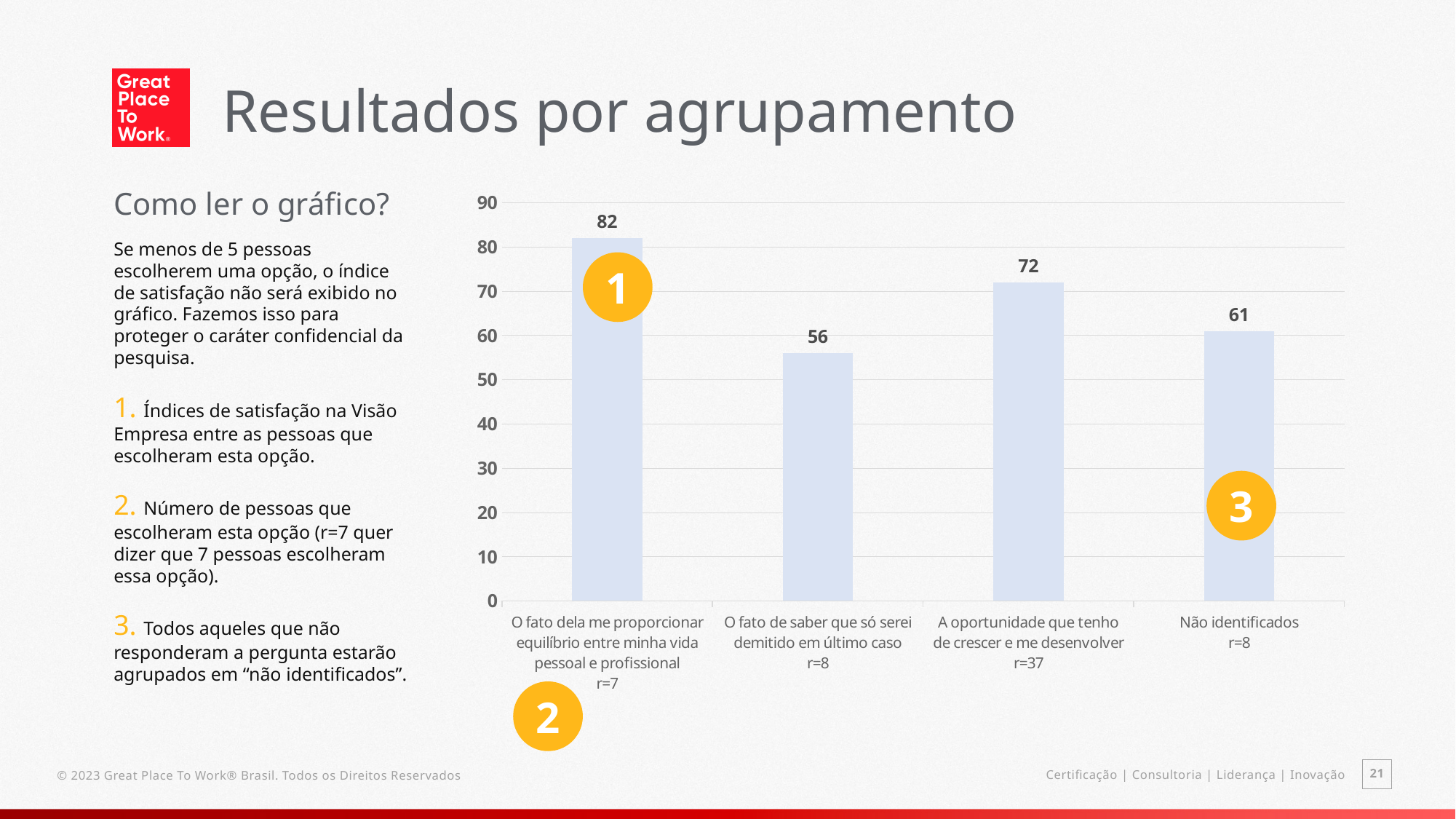
Which category has the highest value? O fato dela me proporcionar equilíbrio entre minha vida pessoal e profissional What is the value for "Não identificados"? 61 Which is larger: the value for "A oportunidade que tenho de crescer e me desenvolver" or the value for "Não identificados"? A oportunidade que tenho de crescer e me desenvolver What is the value for "A oportunidade que tenho de crescer e me desenvolver"? 72 What is the value for "O fato de saber que só serei demitido em último caso"? 56 What is the value for "O fato dela me proporcionar equilíbrio entre minha vida pessoal e profissional"? 82 What is the highest value shown on the vertical axis? 90 What is the difference between the values for "O fato dela me proporcionar equilíbrio entre minha vida pessoal e profissional" and "O fato de saber que só serei demitido em último caso"? 26 How many categories are shown in the chart? 4 What kind of chart is shown on the slide? Bar chart Which category has the lowest value? O fato de saber que só serei demitido em último caso How many people (r) chose the option "A oportunidade que tenho de crescer e me desenvolver"? r=37